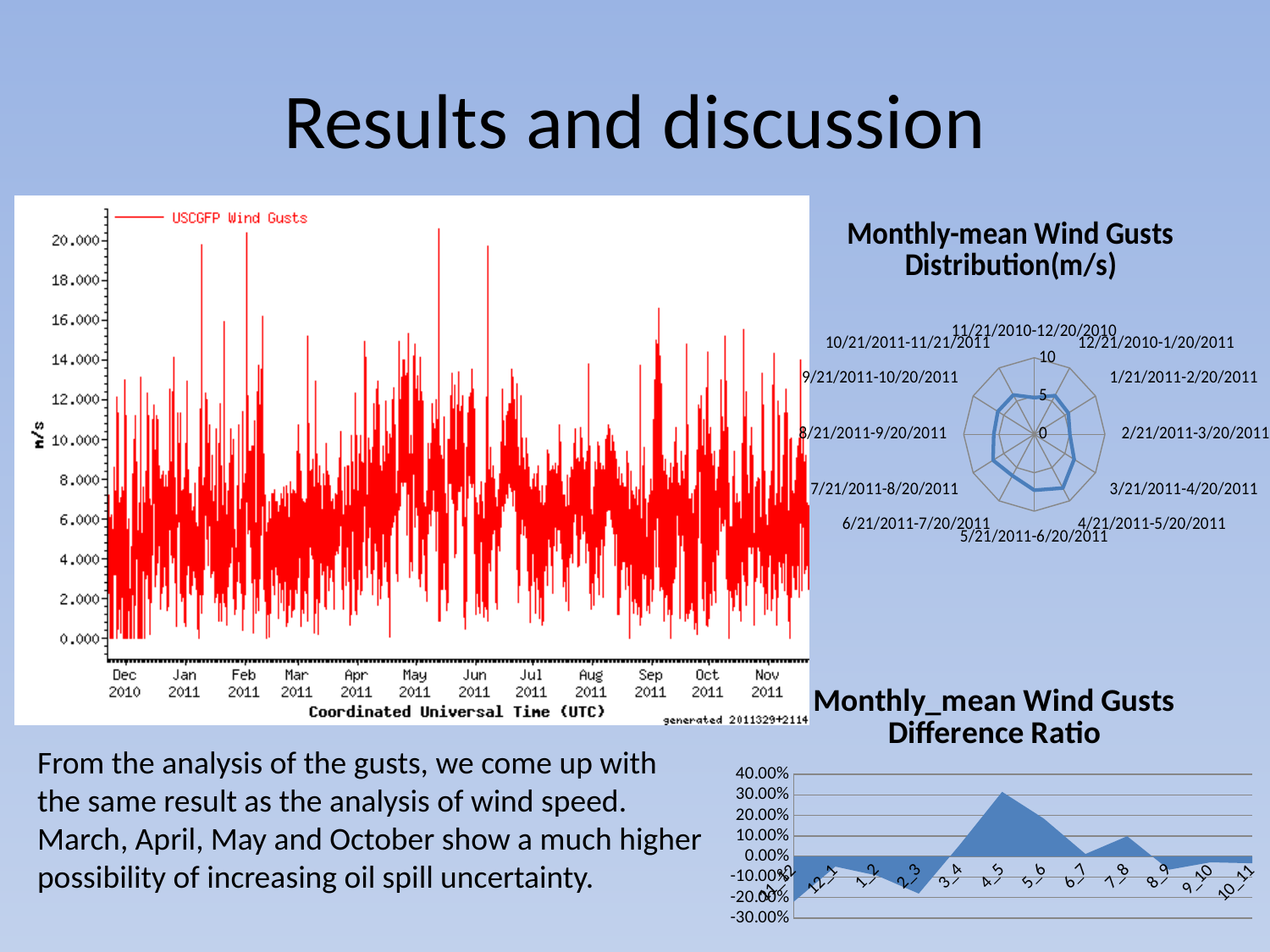
In the 'Monthly_mean Wind Gusts Difference Ratio' chart, which category has the lowest value? 11_12 How many categories are shown on the x axis of the 'Monthly_mean Wind Gusts Difference Ratio' chart? 12 In the 'Monthly_mean Wind Gusts Difference Ratio' chart, which is larger, the value for 4_5 or the value for 7_8? 4_5 In the 'Monthly_mean Wind Gusts Difference Ratio' chart, is the value for 4_5 greater or less than 20.00%? greater What is the legend entry on the red time-series chart on the left of the slide? USCGFP Wind Gusts In the 'Monthly_mean Wind Gusts Difference Ratio' chart, which category has the highest value? 4_5 What type of chart is the 'Monthly_mean Wind Gusts Difference Ratio' chart? Area chart What is the highest tick value on the radial axis of the 'Monthly-mean Wind Gusts Distribution(m/s)' chart? 10 In the 'Monthly-mean Wind Gusts Distribution(m/s)' chart, is the value for 4/21/2011-5/20/2011 greater or less than 5? greater In the 'Monthly_mean Wind Gusts Difference Ratio' chart, is the value for 11_12 greater or less than -10.00%? less How many categories (date ranges) are shown on the 'Monthly-mean Wind Gusts Distribution(m/s)' radar chart? 12 What type of chart is the 'Monthly-mean Wind Gusts Distribution(m/s)' chart? Radar chart